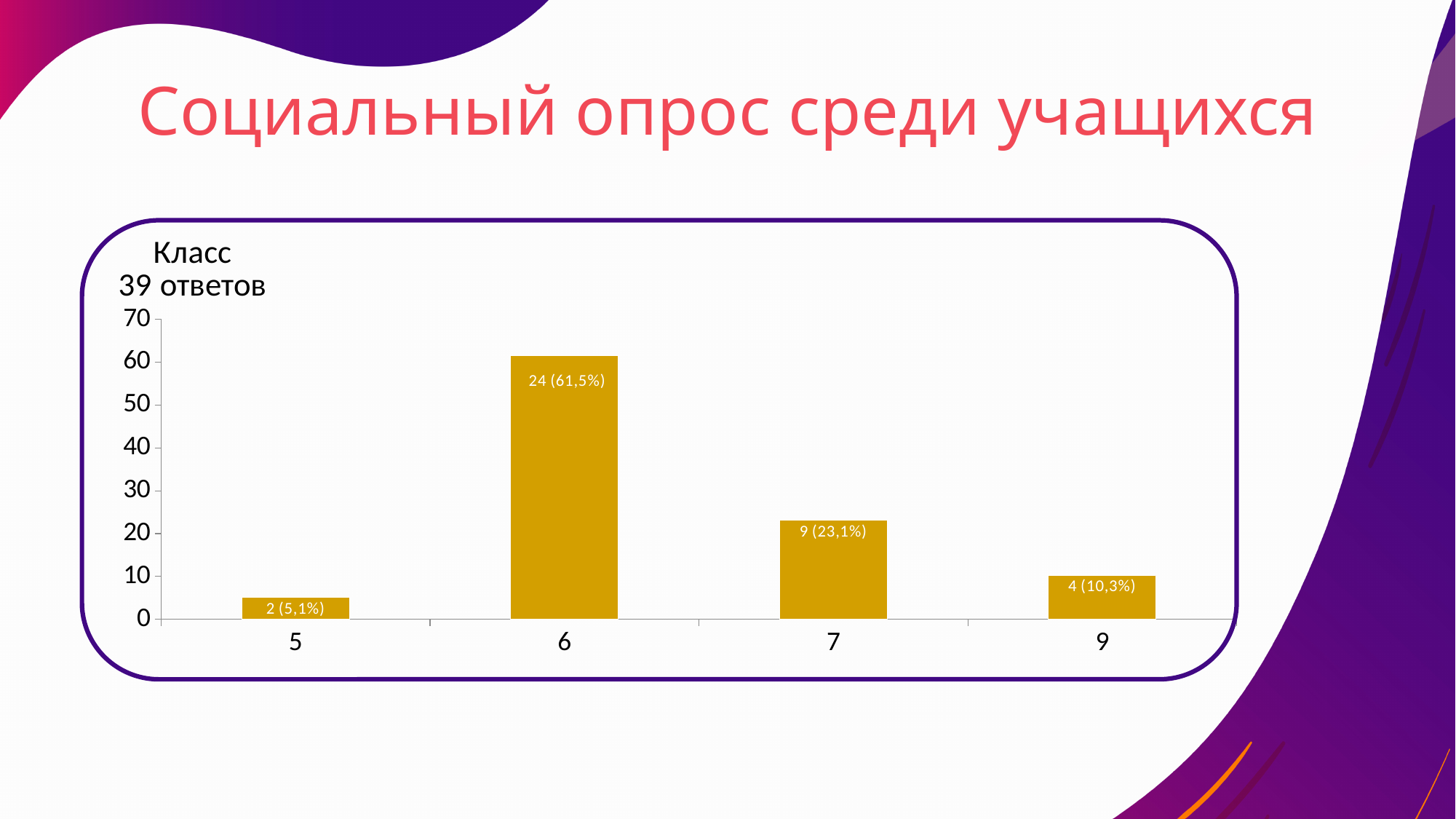
What is the title of the chart? Класс 39 ответов Which class has the lowest bar? 5 What is the data label on the bar for class 7? 9 (23,1%) How many classes are shown on the x axis? 4 Which class has more responses, 7 or 9? 7 What is the data label on the bar for class 9? 4 (10,3%) What kind of chart is shown on the slide? bar chart How many more responses did class 6 give than class 7? 15 Which class has the highest bar? 6 Is the value for class 5 greater or less than 10 on the axis? less What is the data label on the bar for class 5? 2 (5,1%) What is the data label on the bar for class 6? 24 (61,5%)